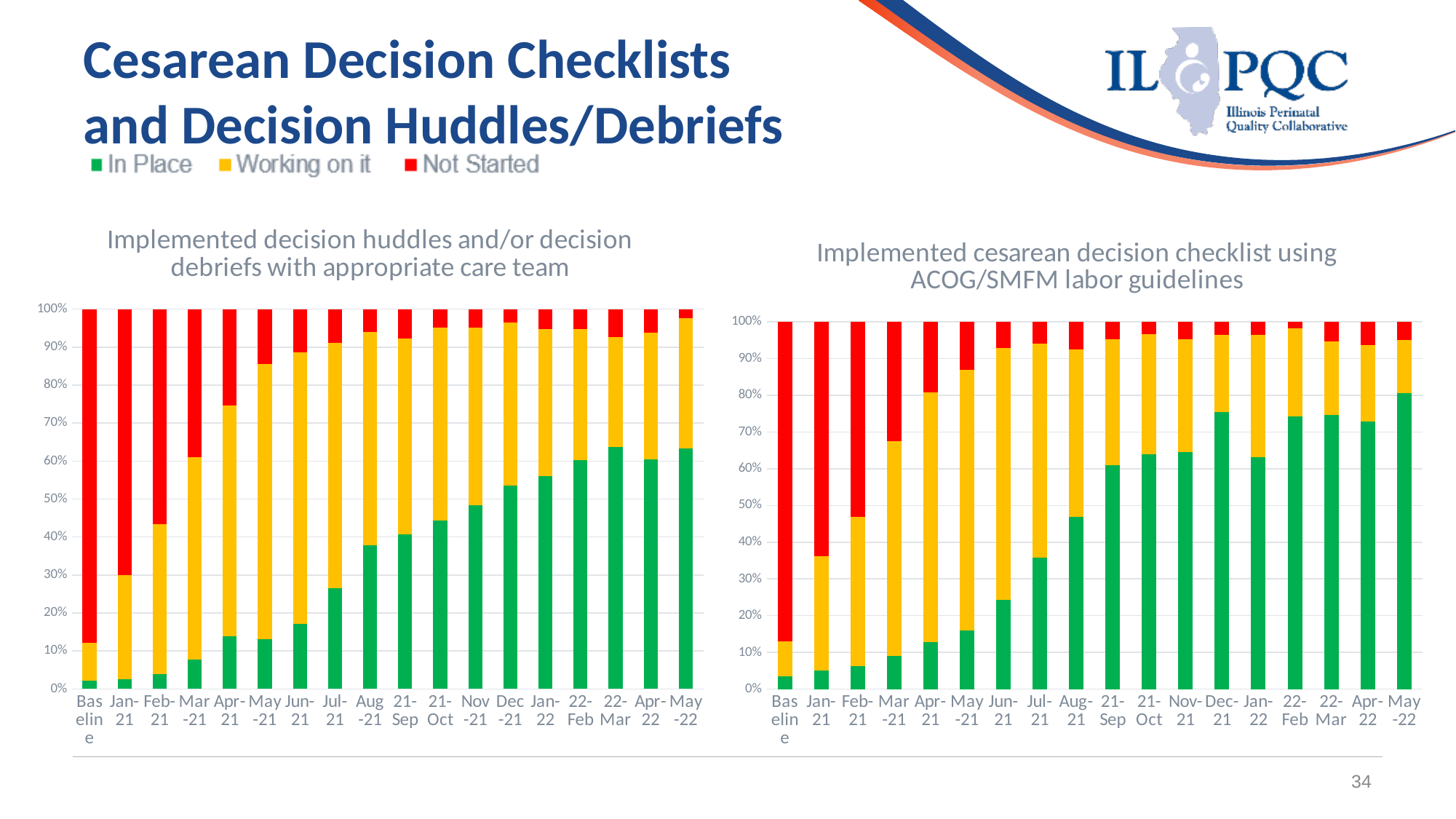
In the chart titled 'Implemented decision huddles and/or decision debriefs with appropriate care team', which has the larger 'In Place' share, Apr-21 or Jul-21? Jul-21 In the chart titled 'Implemented decision huddles and/or decision debriefs with appropriate care team', is the 'In Place' value for Baseline greater or less than 10%? less What kind of chart is used on this slide for the two charts? Stacked bar chart In the chart titled 'Implemented decision huddles and/or decision debriefs with appropriate care team', is the 'In Place' value for May-22 greater or less than 50%? greater In the chart titled 'Implemented cesarean decision checklist using ACOG/SMFM labor guidelines', which period has the highest 'In Place' share? May-22 In the chart titled 'Implemented decision huddles and/or decision debriefs with appropriate care team', does the 'In Place' share generally rise or fall from Baseline to May-22? rise In the chart titled 'Implemented decision huddles and/or decision debriefs with appropriate care team', how many time periods are shown on the x axis? 18 Which colour represents 'Not Started' in the legend? Red In the chart titled 'Implemented cesarean decision checklist using ACOG/SMFM labor guidelines', which has the larger 'In Place' share, Jul-21 or Aug-21? Aug-21 In the chart titled 'Implemented cesarean decision checklist using ACOG/SMFM labor guidelines', is the 'In Place' value for May-22 greater or less than 70%? greater How many series does the legend list? 3